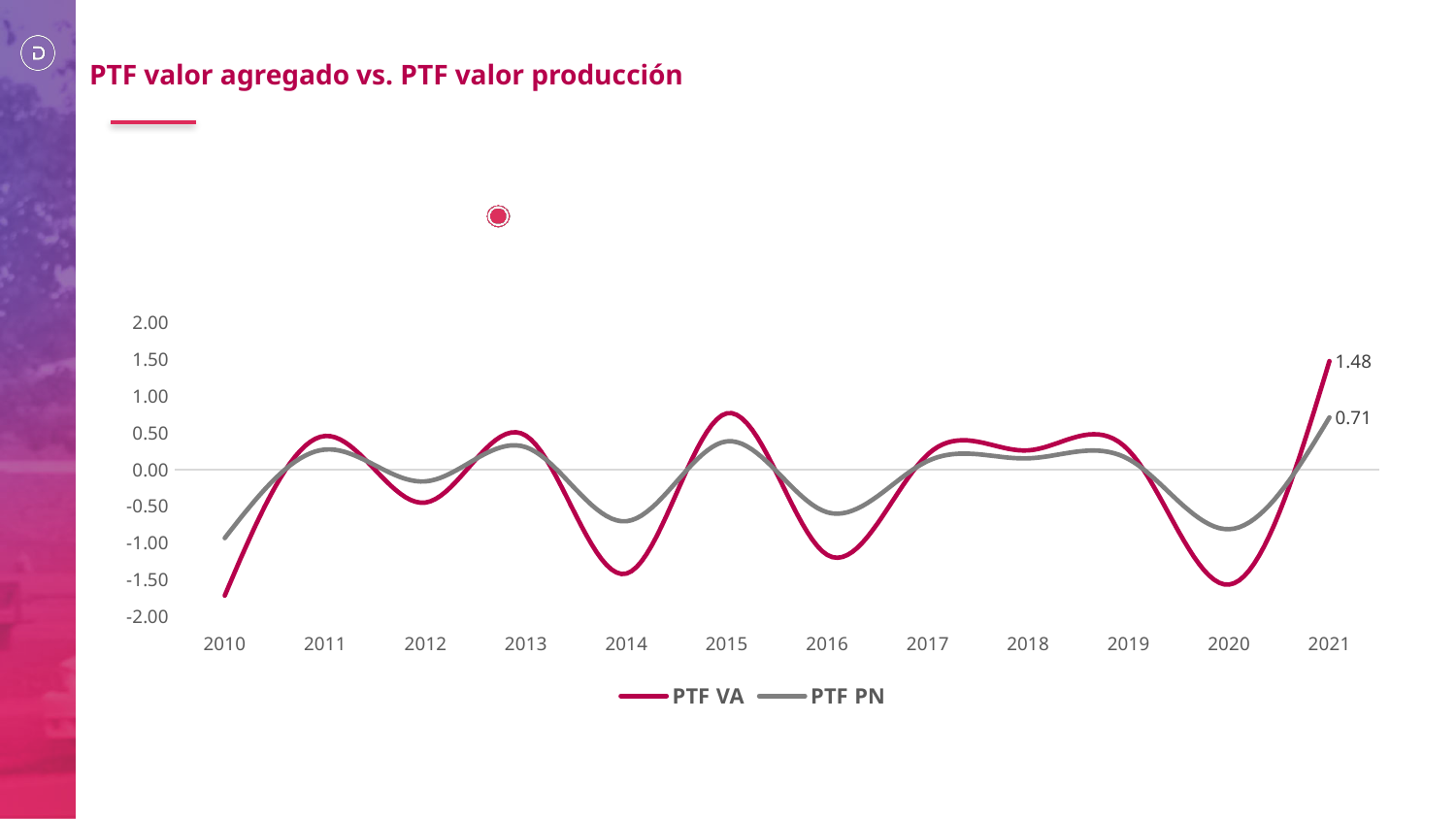
Is the value for PTF VA in 2010 greater or less than -1.00? less How many series does the legend list? 2 What is the value of PTF VA in 2021? 1.48 Is the value for PTF VA in 2020 greater or less than -1.00? less What kind of chart is shown on the slide? Line chart What is the value of PTF PN in 2021? 0.71 Is the value for PTF PN in 2014 greater or less than -0.50? less In 2021, which series has the larger value, PTF VA or PTF PN? PTF VA How many years are shown on the x axis? 12 In which year does PTF VA reach its highest value? 2021 What is the difference between PTF VA and PTF PN in 2021? 0.77